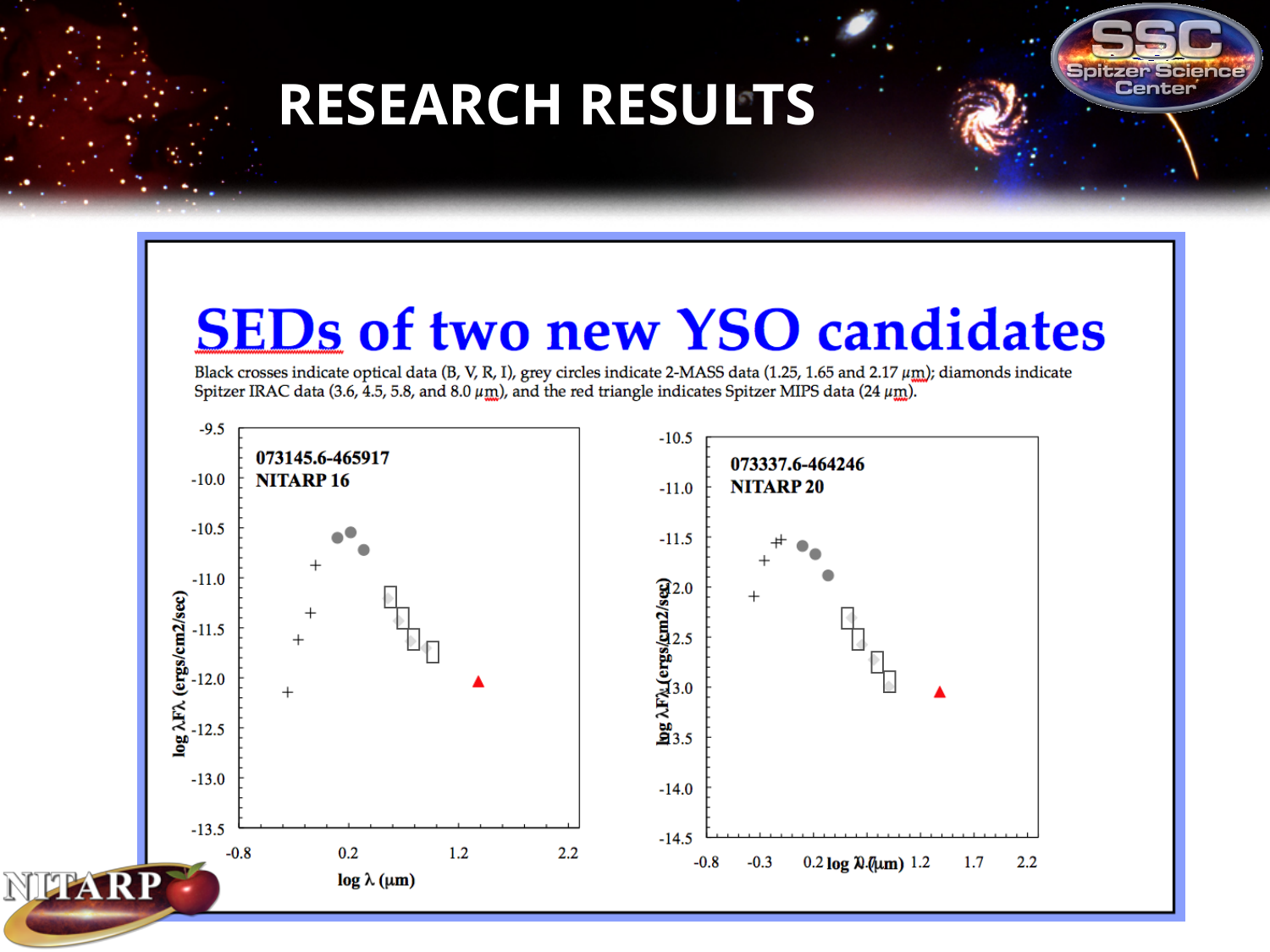
In the right chart (NITARP 20), is the value of the red triangle greater or less than -12.5? less In the left chart (NITARP 16), how many grey circles are plotted? 3 In the right chart (NITARP 20), how many grey circles are plotted? 3 In the left chart (NITARP 16), are the grey circle values greater or less than -11.0? greater In the left chart (NITARP 16), how many red triangles are plotted? 1 What is the overall title above the two charts? SEDs of two new YSO candidates What kind of chart is shown on the left of the slide? scatter plot In the left chart (NITARP 16), is the value of the red triangle greater or less than -11.5? less In the right chart, which NITARP number is labelled? NITARP 20 In the left chart (NITARP 16), do the plotted values rise or fall as log λ increases from 0.2 to 1.2? fall